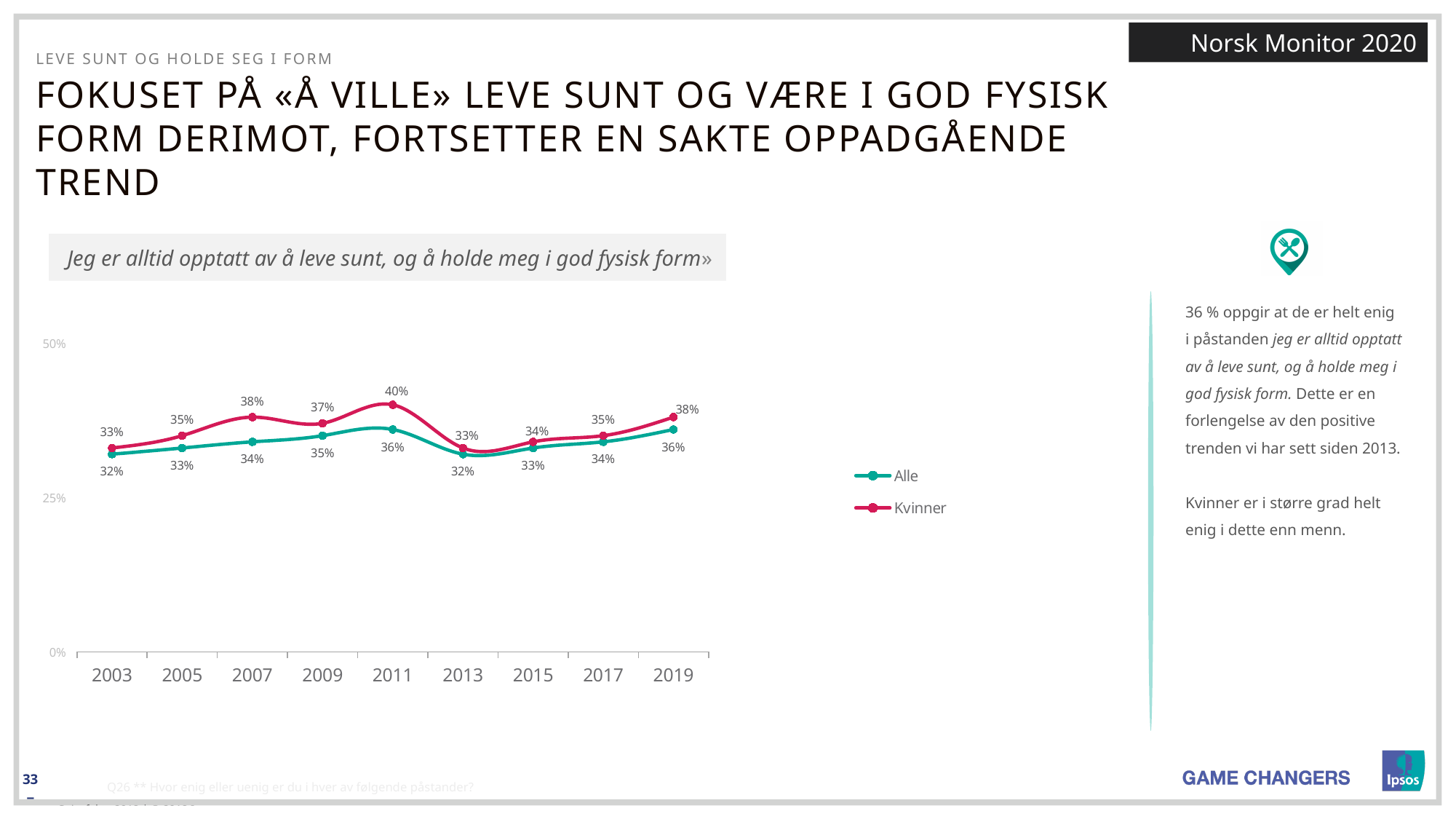
What is the value for Alle in 2019? 36% How many years are plotted along the x axis? 9 What is the value for Kvinner in 2011? 40% In 2007, which series has the higher value, Alle or Kvinner? Kvinner In which year is the Kvinner series at its highest? 2011 How many series does the legend list? 2 Is the value for Alle in 2019 greater or less than 25%? greater What is the value for Alle in 2013? 32% What is the difference between Kvinner and Alle in 2011? 4 percentage points Does the Alle series rise or fall from 2013 to 2019? Rise By how much did the Kvinner value fall from 2011 to 2013? 7 percentage points What kind of chart is shown on the slide? Line chart